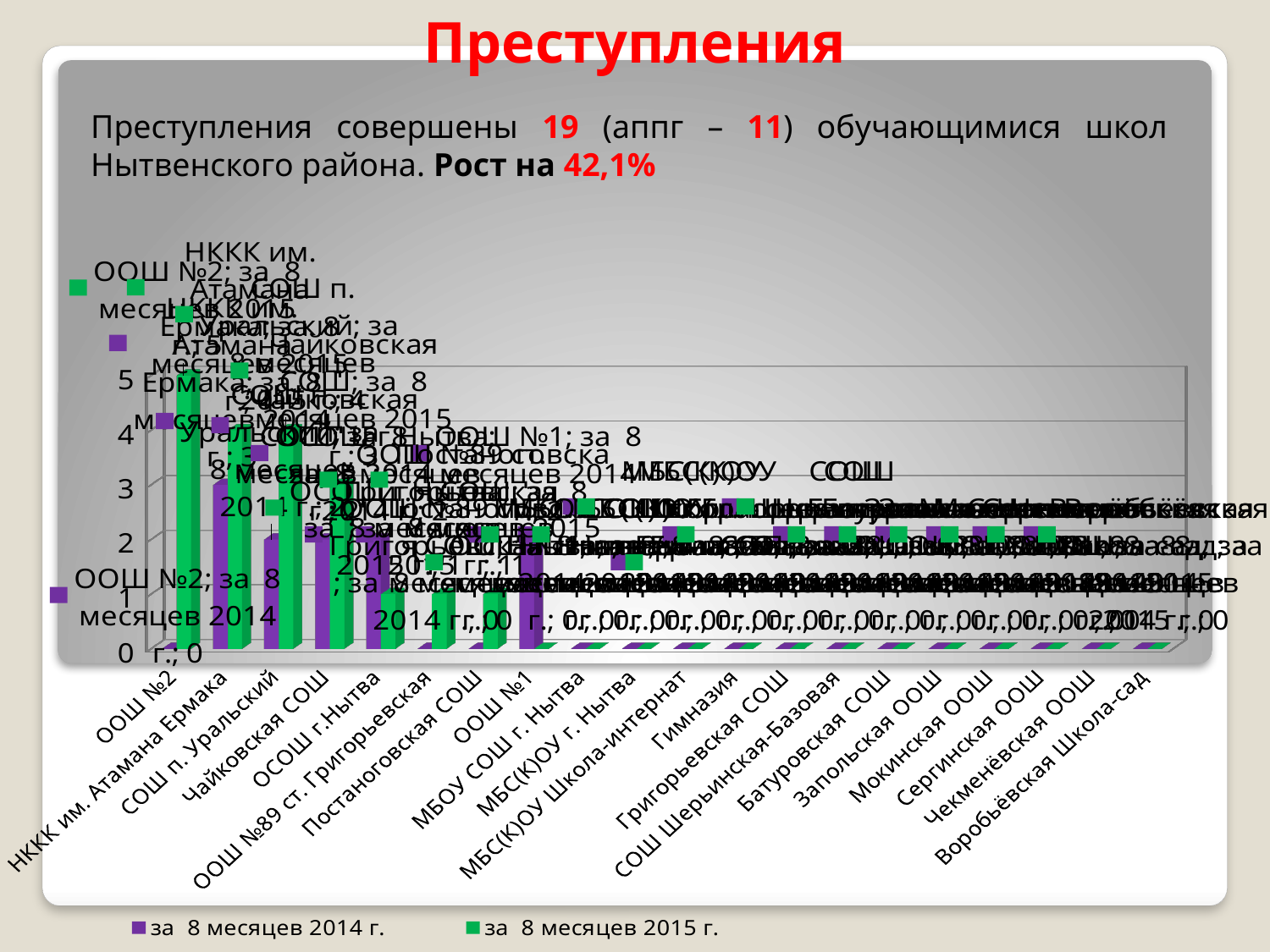
What kind of chart is shown on the slide? bar chart Which is larger in the series 'за 8 месяцев 2015 г.': the value for ООШ №2 or the value for Воробьёвская Школа-сад? ООШ №2 What are the two series named in the legend? за 8 месяцев 2014 г. and за 8 месяцев 2015 г. For ООШ №2, which series has the larger value: 'за 8 месяцев 2014 г.' or 'за 8 месяцев 2015 г.'? за 8 месяцев 2015 г. Is the value for СОШ п. Уральский in the series 'за 8 месяцев 2014 г.' greater or less than 3? less What is the title of the slide containing the chart? Преступления How many series does the legend list? 2 What is the value for ООШ №2 in the series 'за 8 месяцев 2015 г.'? 5 What is the value for ООШ №2 in the series 'за 8 месяцев 2014 г.'? 0 Is the value for НККК им. Атамана Ермака in the series 'за 8 месяцев 2015 г.' greater or less than 3? greater How many schools (categories) are shown on the x axis? 20 Which school has the highest value in the series 'за 8 месяцев 2015 г.'? ООШ №2